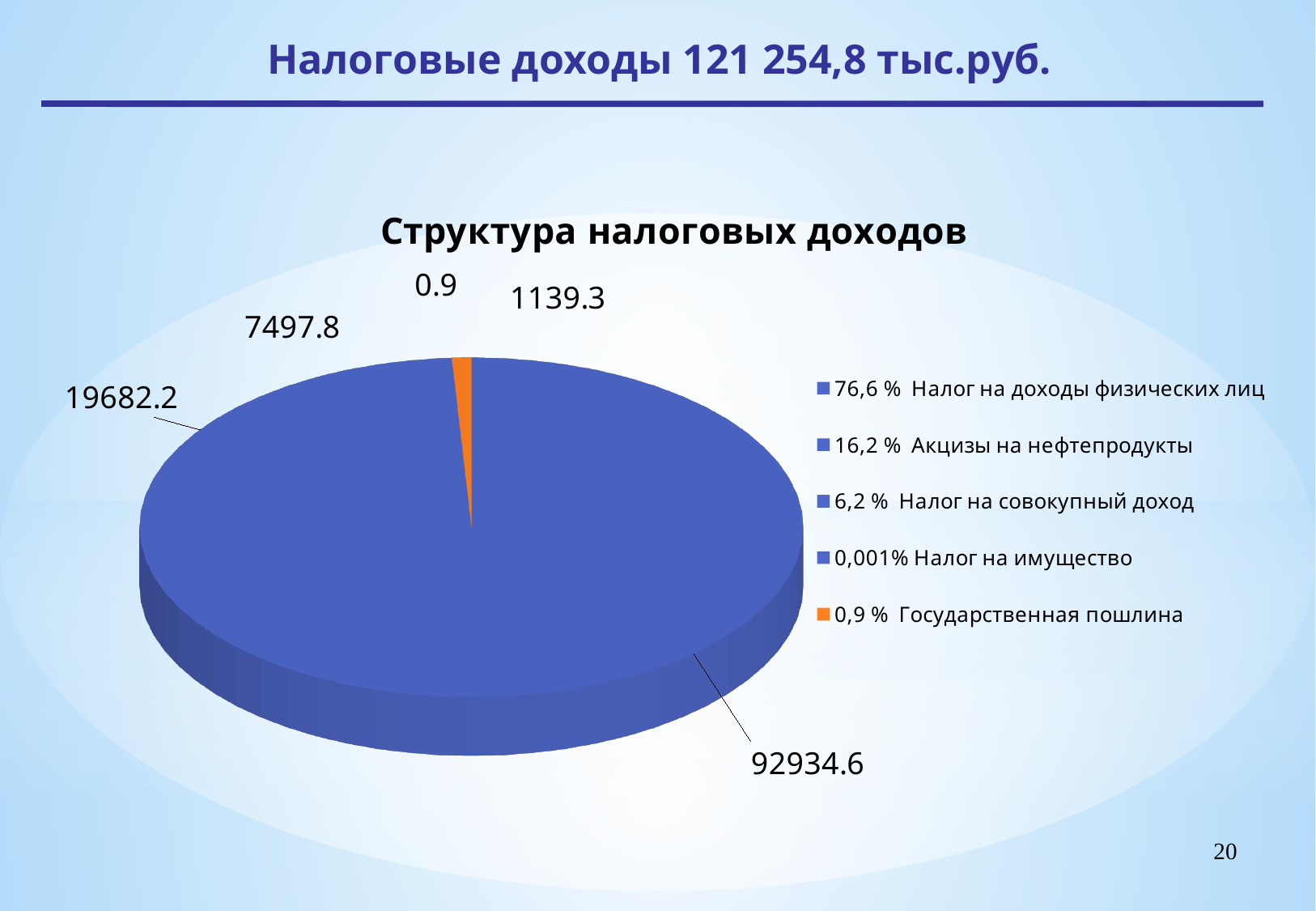
What is the title of the chart? Структура налоговых доходов Which labelled value is larger on the pie chart: 7497.8 or 1139.3? 7497.8 What share of tax revenues does the legend give for Государственная пошлина? 0,9 % What type of chart is shown on the slide? pie chart What is the smallest value labelled on the pie chart? 0.9 How many data labels are printed around the pie chart? 5 What share of tax revenues does the legend give for Акцизы на нефтепродукты? 16,2 % What is the largest value labelled on the pie chart? 92934.6 What is the difference between the two largest labelled values on the pie chart, 92934.6 and 19682.2? 73252.4 How many categories does the legend of the pie chart list? 5 Which legend category is shown in orange on the pie chart? Государственная пошлина What share of tax revenues does the legend give for Налог на доходы физических лиц? 76,6 %